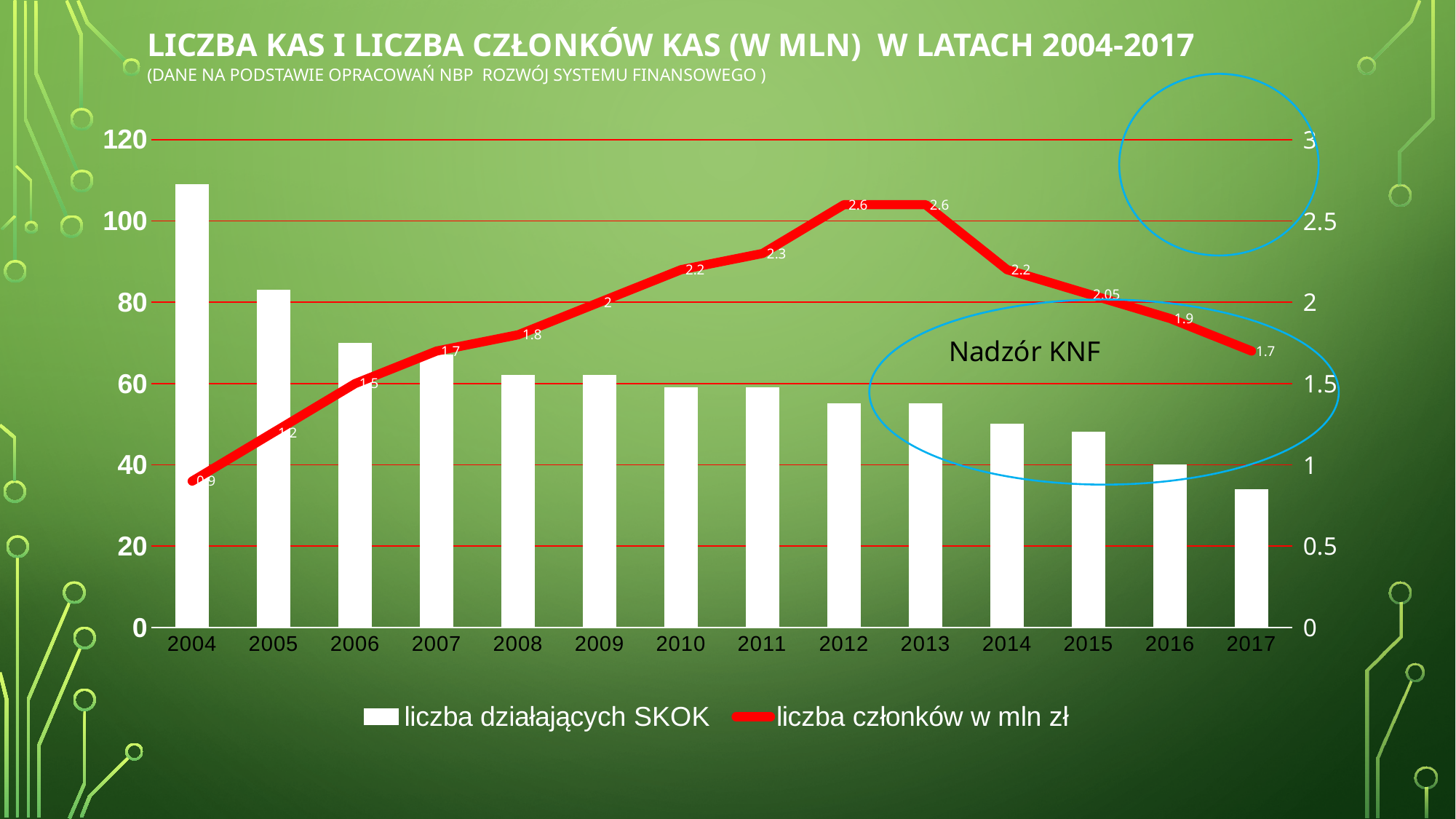
How many years are shown on the x axis of the chart? 14 What is the value of the 'liczba członków w mln zł' line for 2015? 2.05 What is the overall trend of the 'liczba działających SKOK' bars from 2004 to 2017? falling How many series does the legend list? 2 What is the value of the 'liczba członków w mln zł' line for 2004? 0.9 What is the value of the 'liczba członków w mln zł' line for 2017? 1.7 In which year is the 'liczba członków w mln zł' line at its lowest? 2004 Is the 'liczba działających SKOK' bar for 2004 greater or less than 100? greater What is the highest value reached by the 'liczba członków w mln zł' line? 2.6 Which year has the larger 'liczba członków w mln zł' value, 2010 or 2015? 2010 Is the 'liczba działających SKOK' bar for 2017 greater or less than 40? less What is the difference between the 'liczba członków w mln zł' values for 2013 and 2017? 0.9